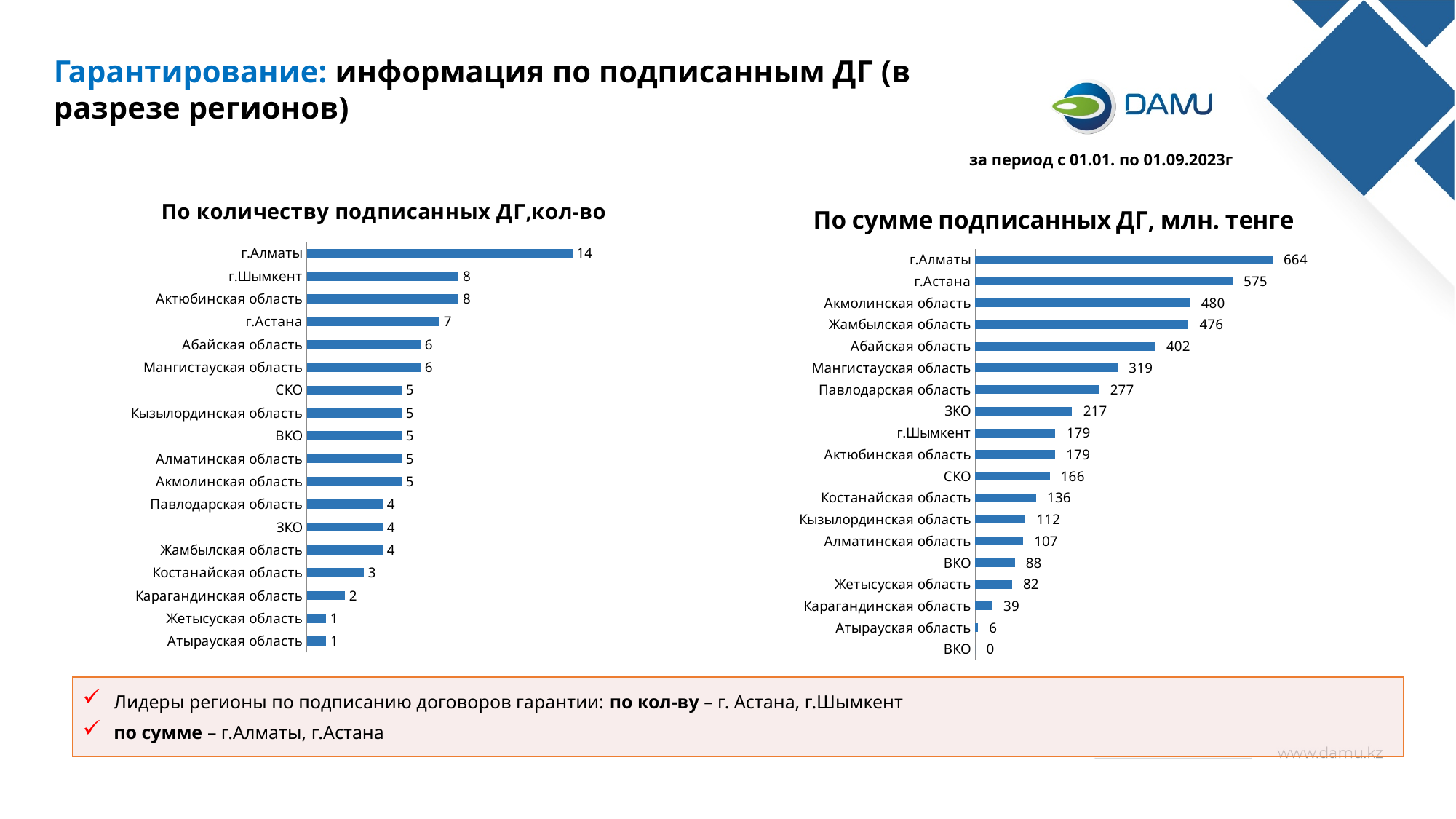
In the chart 'По сумме подписанных ДГ, млн. тенге', what is the difference between г.Алматы and г.Астана? 89 In the chart 'По сумме подписанных ДГ, млн. тенге', which category has the highest value? г.Алматы In the chart 'По сумме подписанных ДГ, млн. тенге', which is larger: Абайская область or Мангистауская область? Абайская область In the chart 'По количеству подписанных ДГ,кол-во', which category has the highest value? г.Алматы In the chart 'По количеству подписанных ДГ,кол-во', how many categories are shown? 18 What is the title of the chart on the left side of the slide? По количеству подписанных ДГ,кол-во In the chart 'По сумме подписанных ДГ, млн. тенге', what is the value for г.Астана? 575 In the chart 'По количеству подписанных ДГ,кол-во', what is the difference between г.Алматы and г.Астана? 7 In the chart 'По количеству подписанных ДГ,кол-во', what is the value for г.Алматы? 14 In the chart 'По сумме подписанных ДГ, млн. тенге', what is the value for Павлодарская область? 277 In the chart 'По количеству подписанных ДГ,кол-во', what is the value for Костанайская область? 3 What type of chart is 'По сумме подписанных ДГ, млн. тенге'? bar chart